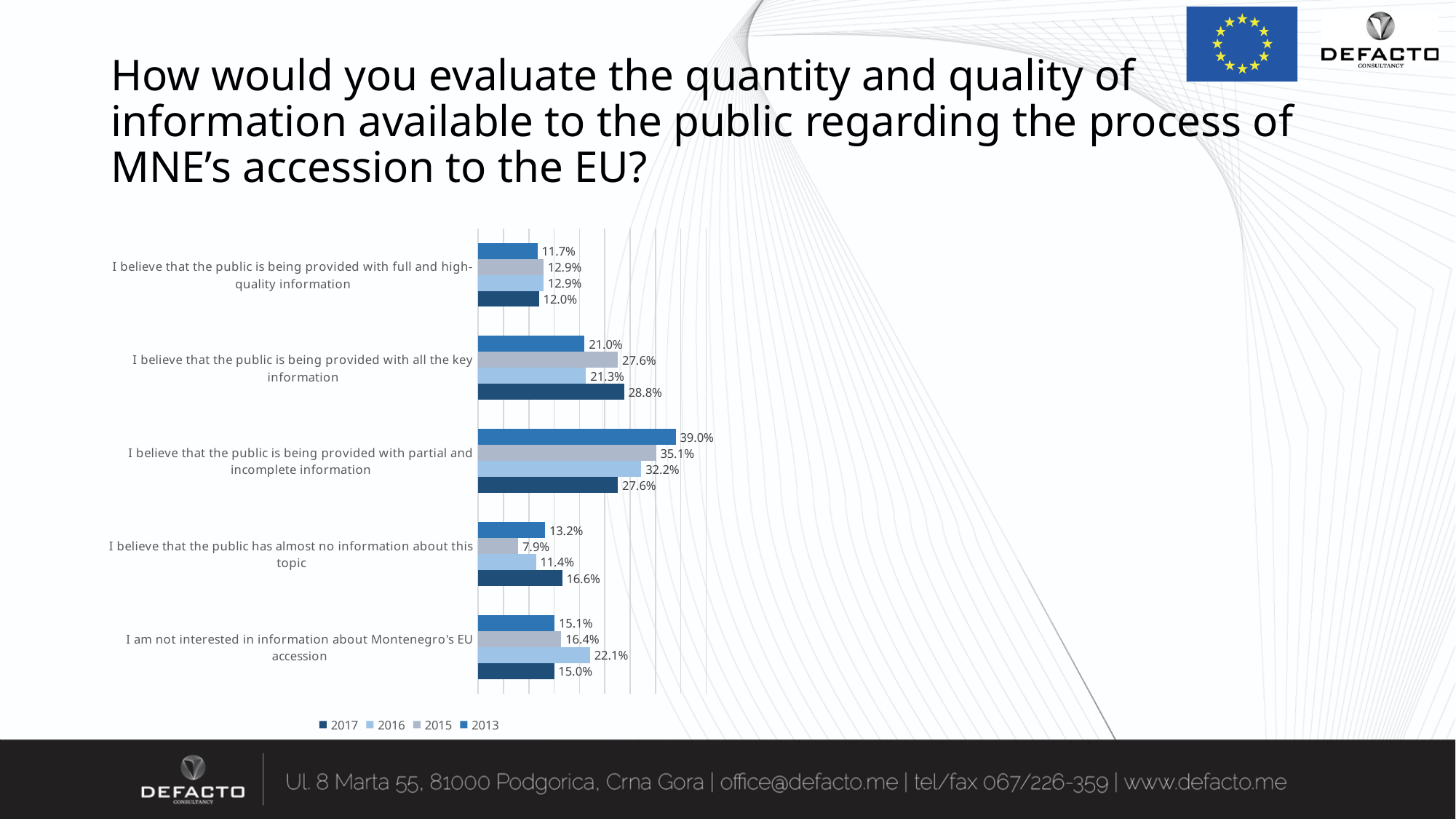
What is the 2015 value for "I believe that the public has almost no information about this topic"? 7.9% Which response category has the highest 2013 value? I believe that the public is being provided with partial and incomplete information How many response categories are shown on the chart? 5 For "I believe that the public is being provided with all the key information", which is larger: the 2015 value or the 2016 value? 2015 How many series does the legend list? 4 Which years are listed in the chart legend? 2017, 2016, 2015, 2013 What kind of chart is shown on the slide? bar chart What is the 2013 value for "I believe that the public is being provided with partial and incomplete information"? 39.0% What is the difference between the 2013 and 2017 values for "I believe that the public is being provided with partial and incomplete information"? 11.4% Which response category has the lowest 2015 value? I believe that the public has almost no information about this topic What is the 2017 value for "I believe that the public is being provided with all the key information"? 28.8% What is the 2016 value for "I am not interested in information about Montenegro's EU accession"? 22.1%